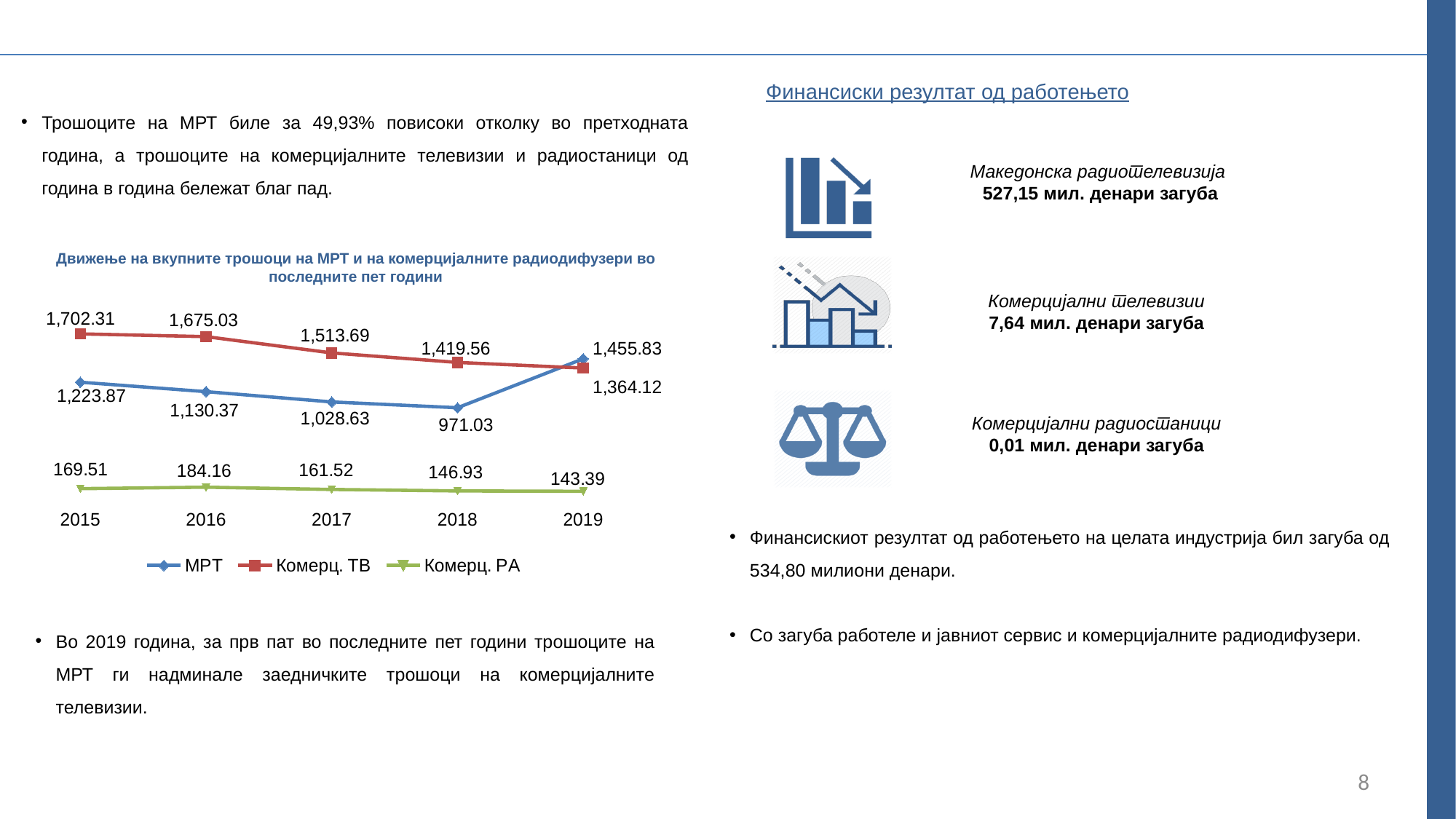
What is the value for Комерц. РА in 2018? 146.93 Does the Комерц. ТВ series rise or fall from 2015 to 2019? Fall How many years are shown on the x axis of the chart? 5 What is the value for МРТ in 2019? 1,455.83 What is the difference between МРТ and Комерц. ТВ in 2019? 91.71 What is the value for Комерц. ТВ in 2015? 1,702.31 How many series does the chart legend list? 3 In which year is the МРТ series at its lowest? 2018 By how much did Комерц. ТВ fall from 2015 to 2019? 338.19 Which is larger in 2018, МРТ or Комерц. ТВ? Комерц. ТВ What type of chart is shown on the slide? Line chart In which year is the Комерц. РА series at its highest? 2016